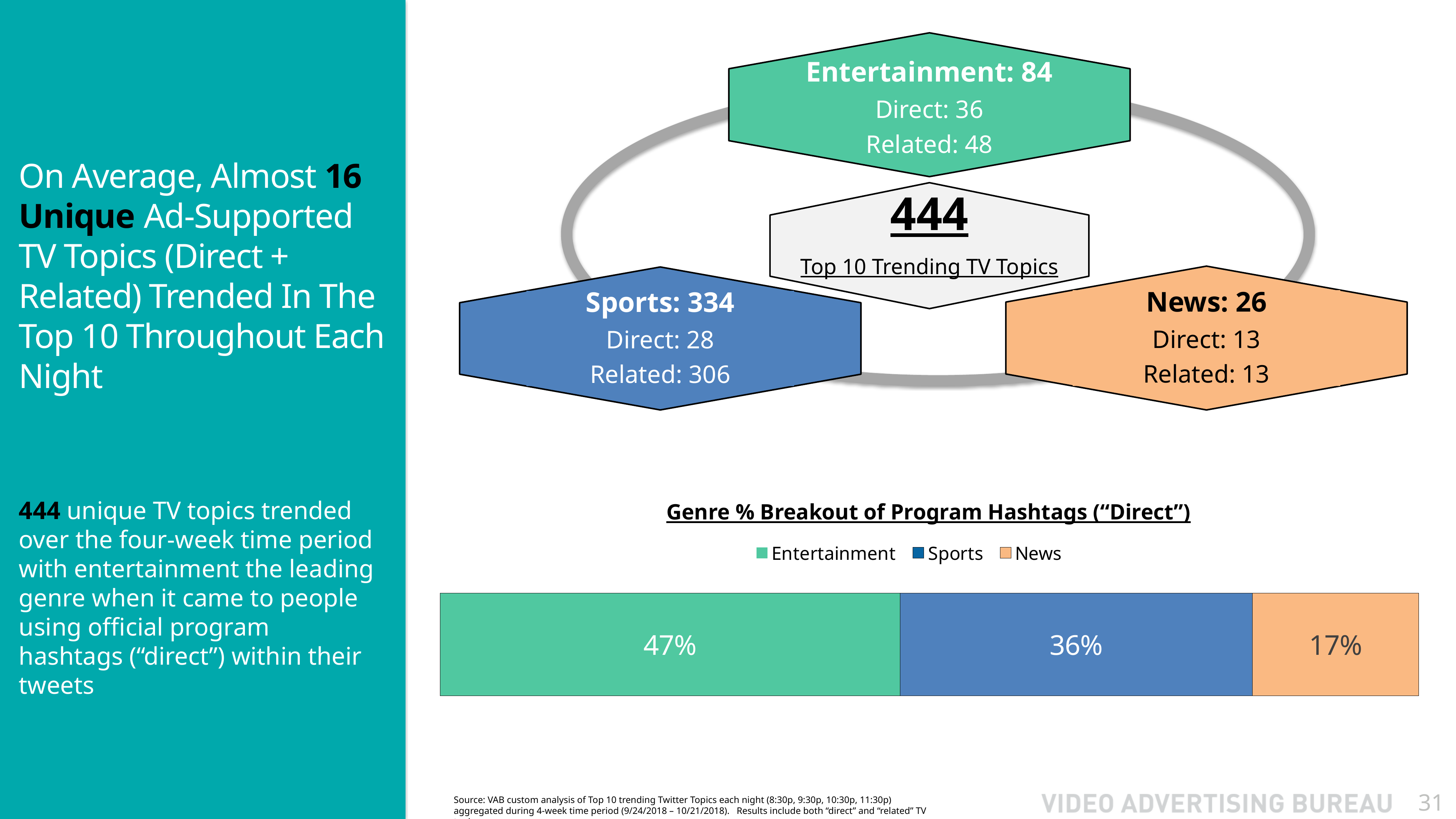
What kind of chart is the chart titled "Genre % Breakout of Program Hashtags ("Direct")"? Stacked bar chart In the chart titled "Genre % Breakout of Program Hashtags ("Direct")", what is the difference between the Entertainment and Sports values? 11% In the chart titled "Genre % Breakout of Program Hashtags ("Direct")", which genre has the highest share? Entertainment In the chart titled "Genre % Breakout of Program Hashtags ("Direct")", what is the value for News? 17% In the chart titled "Genre % Breakout of Program Hashtags ("Direct")", which is larger, the value for Sports or the value for News? Sports How many series does the legend of the chart titled "Genre % Breakout of Program Hashtags ("Direct")" list? 3 In the chart titled "Genre % Breakout of Program Hashtags ("Direct")", what is the value for Sports? 36% In the chart titled "Genre % Breakout of Program Hashtags ("Direct")", what colour is the Sports segment? Blue In the chart titled "Genre % Breakout of Program Hashtags ("Direct")", what is the difference between the Sports and News values? 19% In the chart titled "Genre % Breakout of Program Hashtags ("Direct")", what is the total of the three segments in the stacked bar? 100% In the chart titled "Genre % Breakout of Program Hashtags ("Direct")", what is the value for Entertainment? 47% In the chart titled "Genre % Breakout of Program Hashtags ("Direct")", which genre has the lowest share? News